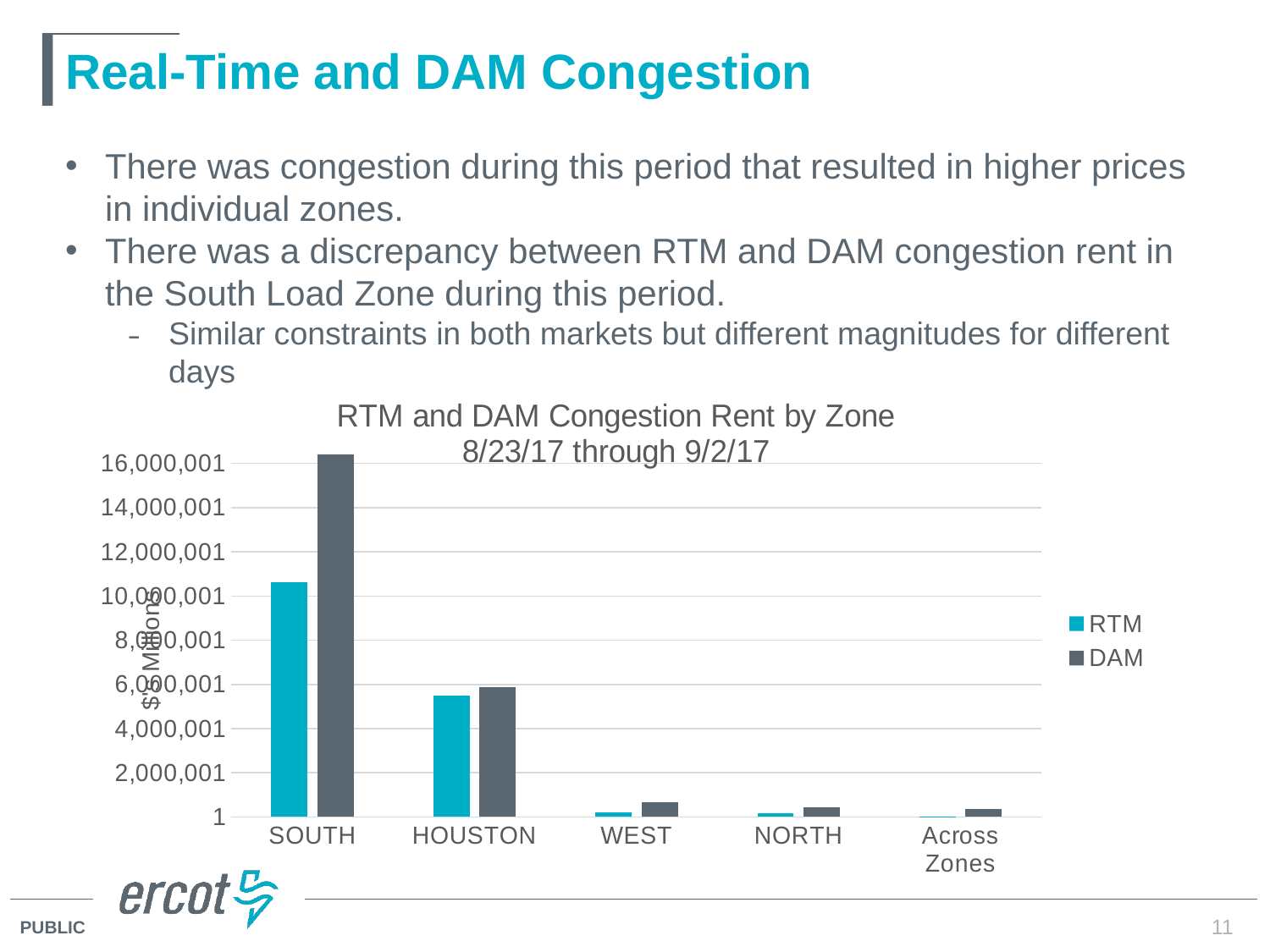
Is the RTM value for HOUSTON greater or less than 6,000,001? less What kind of chart is shown on the slide? Bar chart How many series does the chart's legend list? 2 For the SOUTH zone, which is larger, the RTM or the DAM congestion rent? DAM Which zone has the highest RTM congestion rent? SOUTH What date range is given in the chart's title? 8/23/17 through 9/2/17 Which zone has the highest DAM congestion rent? SOUTH Is the DAM value for SOUTH greater or less than 16,000,001? greater Is the RTM value for SOUTH greater or less than 10,000,001? greater Do the congestion rent values generally rise or fall moving from SOUTH to Across Zones along the x axis? fall How many zone categories are shown on the x axis of the chart? 5 Which category has the lowest RTM congestion rent? Across Zones